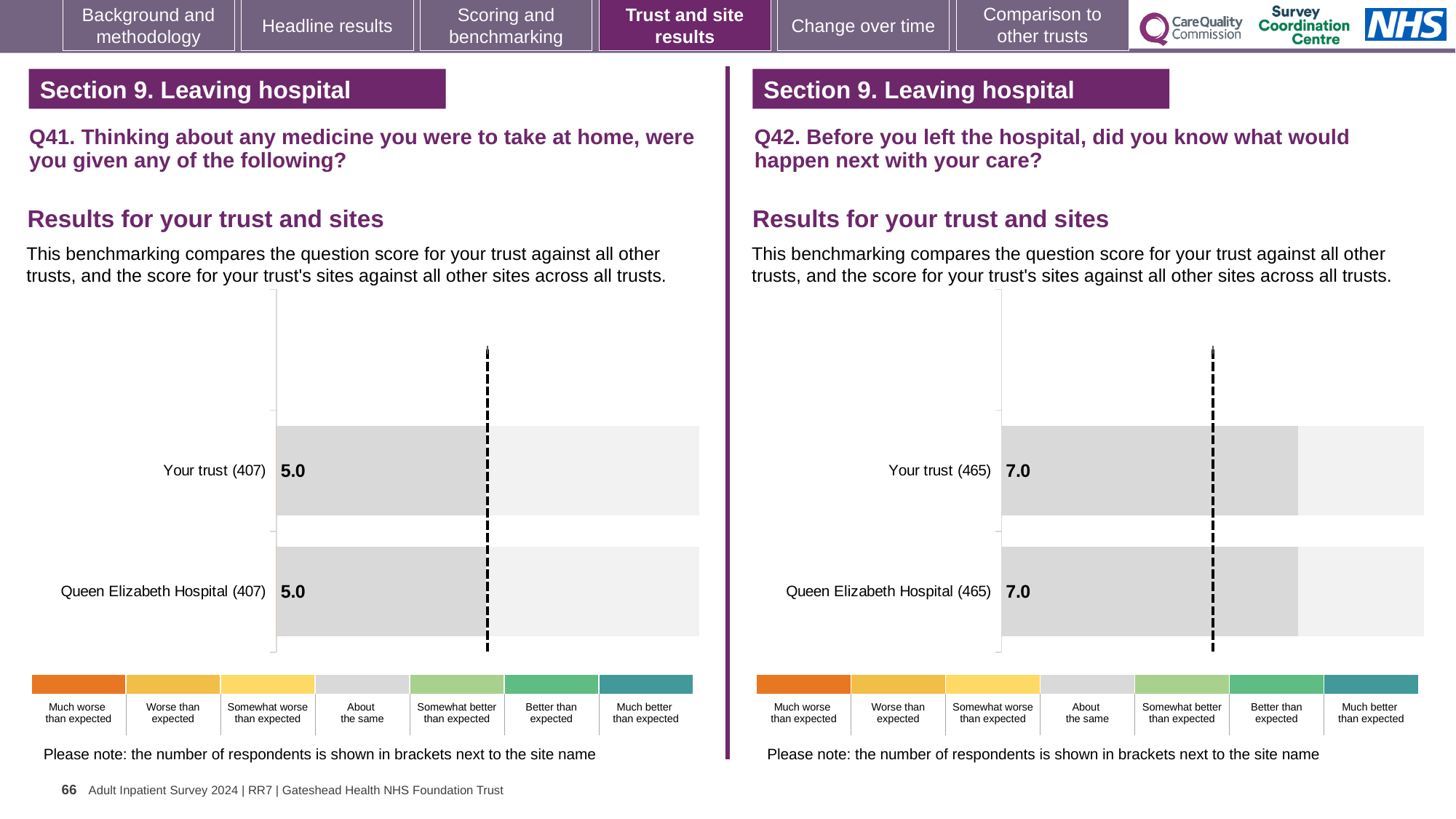
In the Q42 chart on the right, what is the score for Your trust? 7.0 How many bars are plotted in the Q42 chart on the right? 2 In the Q42 chart on the right, how many respondents are shown in brackets next to Queen Elizabeth Hospital? 465 What kind of chart is the Q42 chart on the right? Bar chart What kind of chart is the Q41 chart on the left? Bar chart How many bars are plotted in the Q41 chart on the left? 2 In the Q42 chart on the right, what is the score for Queen Elizabeth Hospital? 7.0 In the Q41 chart on the left, what is the score for Your trust? 5.0 In the Q42 chart on the right, what is the difference between the score for Your trust and the score for Queen Elizabeth Hospital? 0.0 In the Q41 chart on the left, how many respondents are shown in brackets next to Your trust? 407 In the Q41 chart on the left, what is the score for Queen Elizabeth Hospital? 5.0 In the Q41 chart on the left, what is the difference between the score for Your trust and the score for Queen Elizabeth Hospital? 0.0